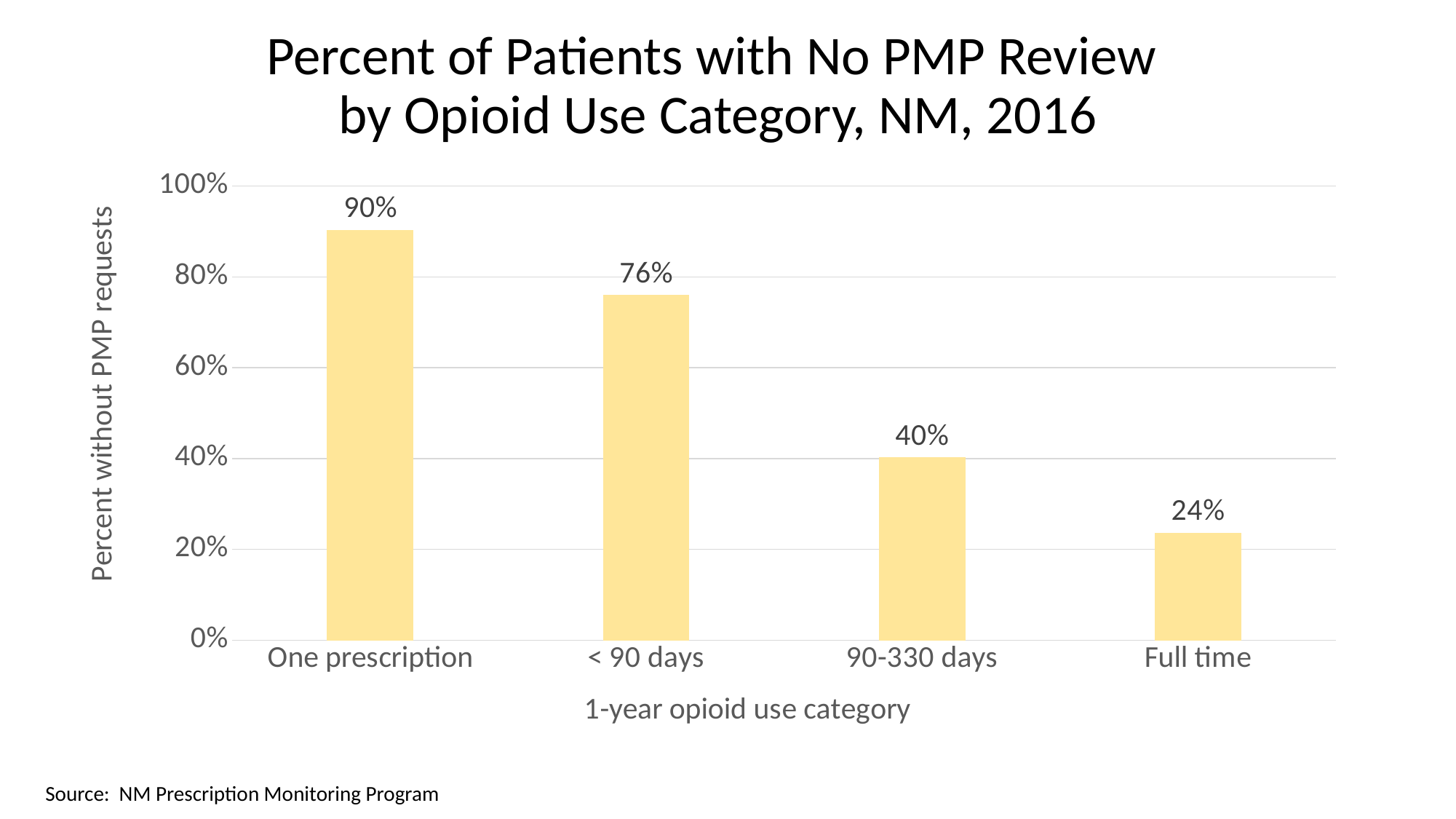
Do the values rise or fall moving from left to right along the x axis? Fall Which opioid use category has the highest percent of patients with no PMP review? One prescription What is the label of the y axis? Percent without PMP requests Which is larger, the value for < 90 days or the value for 90-330 days? < 90 days What is the percent of patients with no PMP review for the One prescription category? 90% What is the value for the 90-330 days category? 40% What kind of chart is shown on the slide? Bar chart Which opioid use category has the lowest percent of patients with no PMP review? Full time What is the difference in percentage points between the One prescription and Full time categories? 66 What is the value for the < 90 days category? 76% What is the value for the Full time category? 24% How many opioid use categories are shown on the x axis? 4